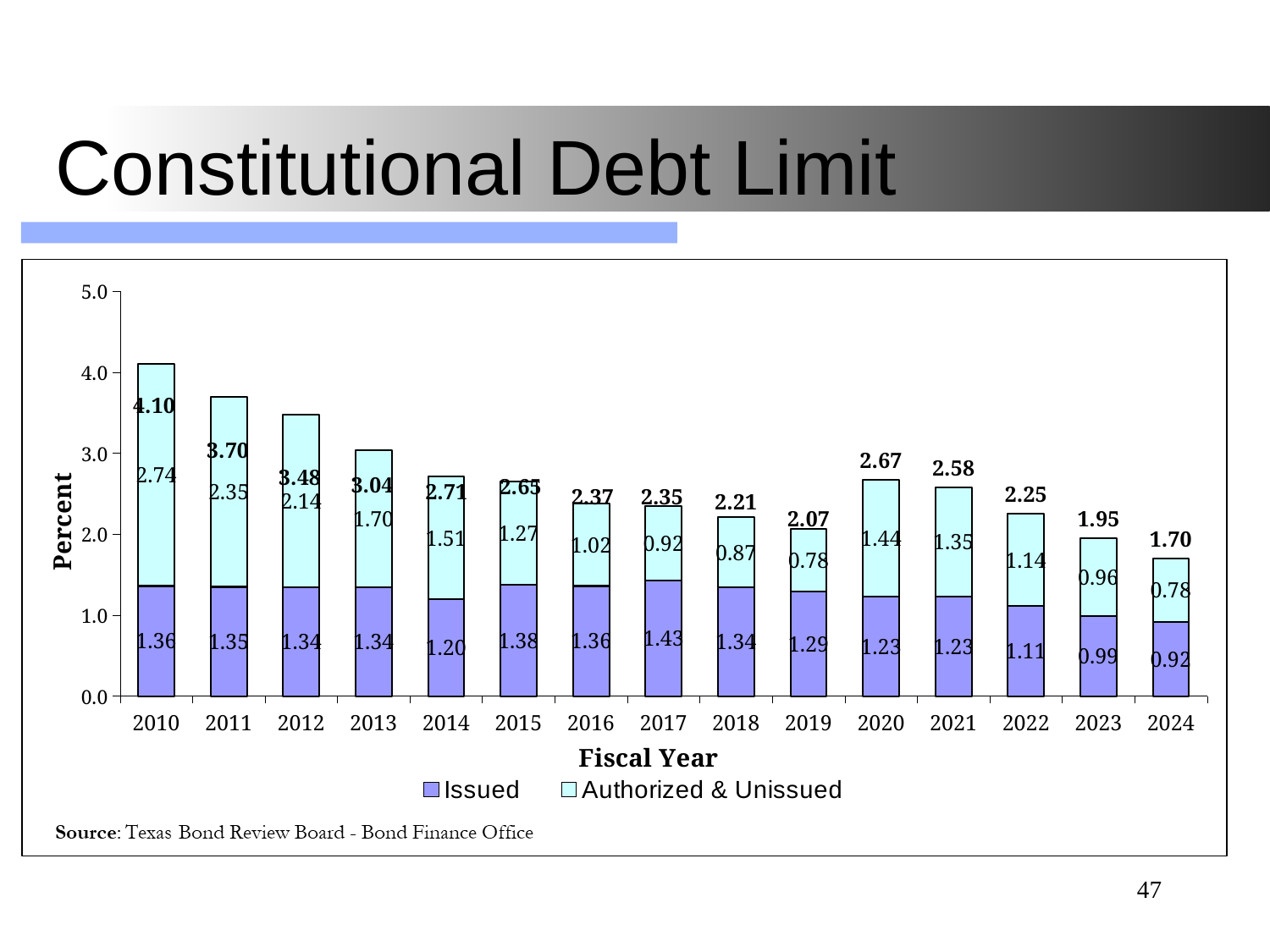
What is the Issued value for fiscal year 2017? 1.43 What is the difference between the Authorized & Unissued values for 2010 and 2011? 0.39 Which fiscal year has the lowest total stacked bar? 2024 What is the total of the stacked bar for fiscal year 2010? 4.10 Which fiscal year has the larger Issued value, 2014 or 2015? 2015 How many series does the legend list? 2 Which fiscal year has the highest total stacked bar? 2010 How many fiscal years are shown on the x axis? 15 Do the total stacked bar values rise or fall from 2010 to 2019? Fall What kind of chart is shown on the slide? Stacked bar chart What is the title of the x axis? Fiscal Year What is the Authorized & Unissued value for fiscal year 2020? 1.44